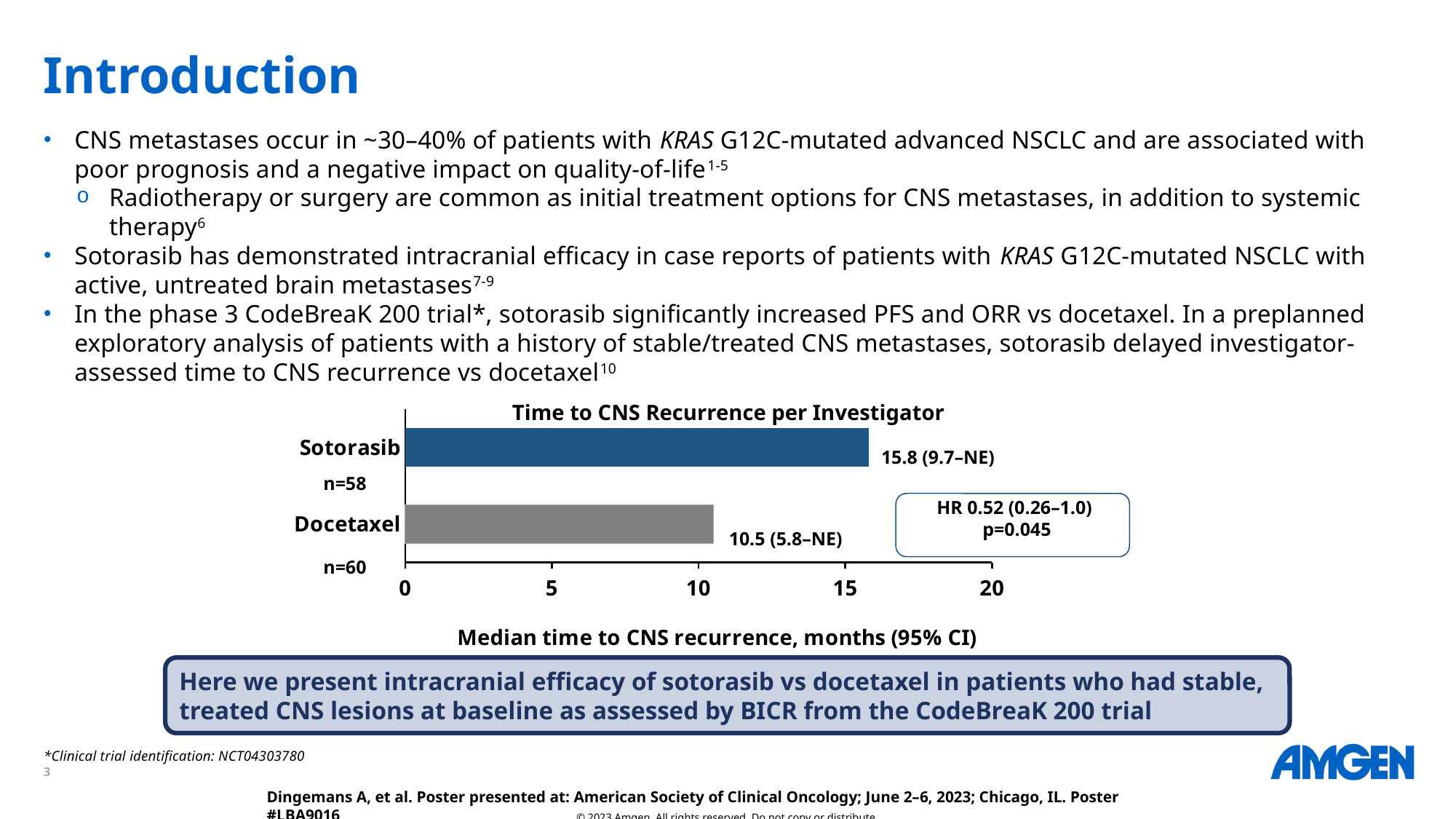
Is the median time to CNS recurrence for Docetaxel greater or less than 10? greater Which treatment has the longer median time to CNS recurrence? Sotorasib What kind of chart is shown on the slide? Bar chart What is the median time to CNS recurrence for Docetaxel? 10.5 months What is the 95% confidence interval shown for Sotorasib's median time to CNS recurrence? 9.7–NE What is the median time to CNS recurrence for Sotorasib? 15.8 months What is the title of the chart? Time to CNS Recurrence per Investigator What hazard ratio is shown in the chart? HR 0.52 (0.26–1.0) What is the difference in median time to CNS recurrence between Sotorasib and Docetaxel? 5.3 months How many treatment groups are shown in the chart? 2 Which treatment has the shorter median time to CNS recurrence? Docetaxel Is the median time to CNS recurrence for Sotorasib greater or less than 15? greater